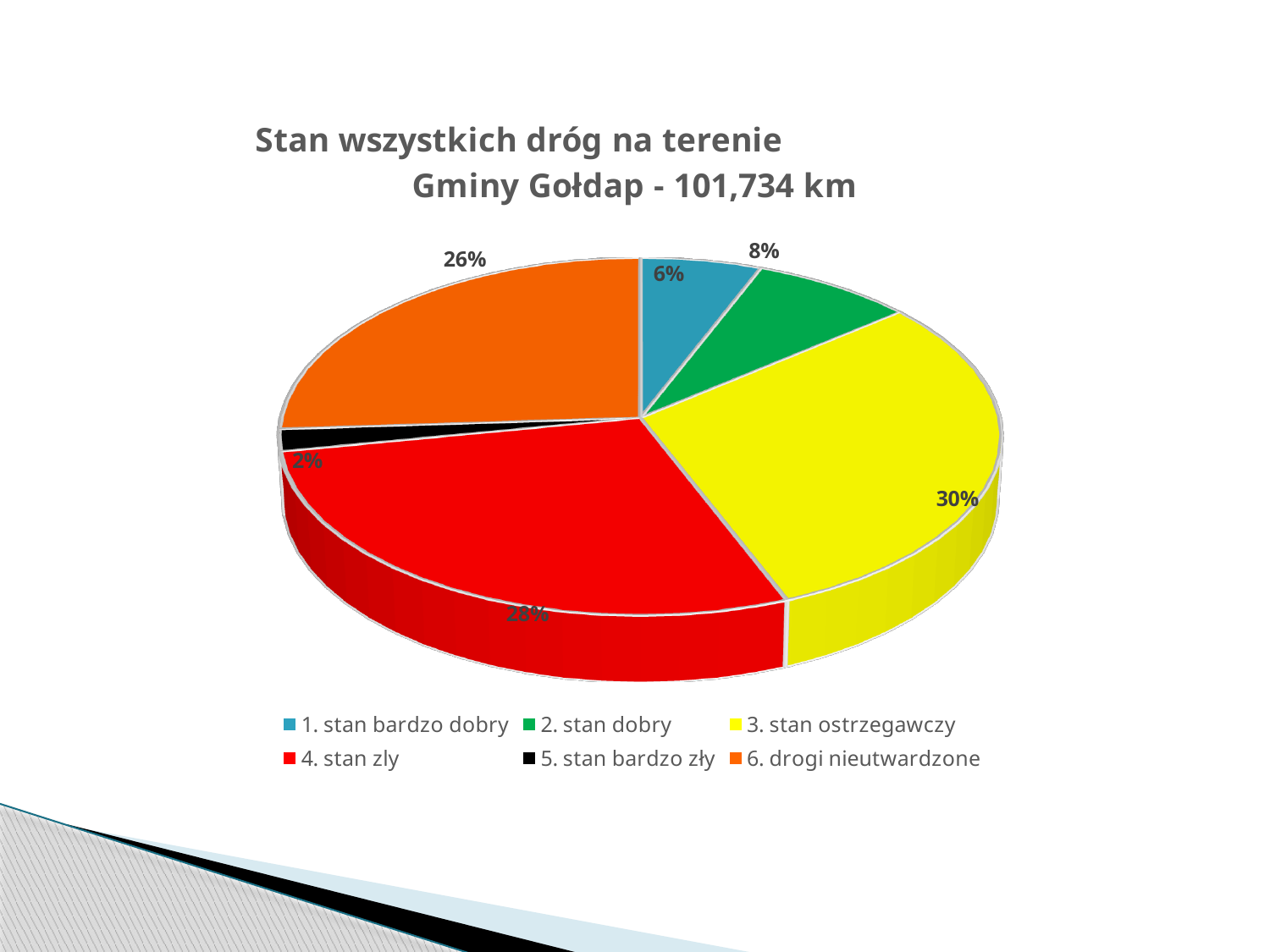
What share of the pie does "6. drogi nieutwardzone" have? 26% What is the title of the chart? Stan wszystkich dróg na terenie Gminy Gołdap - 101,734 km Which category has the smallest slice of the pie? 5. stan bardzo zły What share of the pie does "1. stan bardzo dobry" have? 6% What share of the pie does "3. stan ostrzegawczy" have? 30% What share of the pie does "2. stan dobry" have? 8% How many categories does the legend list? 6 What is the difference in percentage points between "3. stan ostrzegawczy" and "4. stan zly"? 2 What kind of chart is shown on the slide? pie chart Which is larger: the slice for "6. drogi nieutwardzone" or the slice for "2. stan dobry"? 6. drogi nieutwardzone What share of the pie does "5. stan bardzo zły" have? 2% Which category has the largest slice of the pie? 3. stan ostrzegawczy